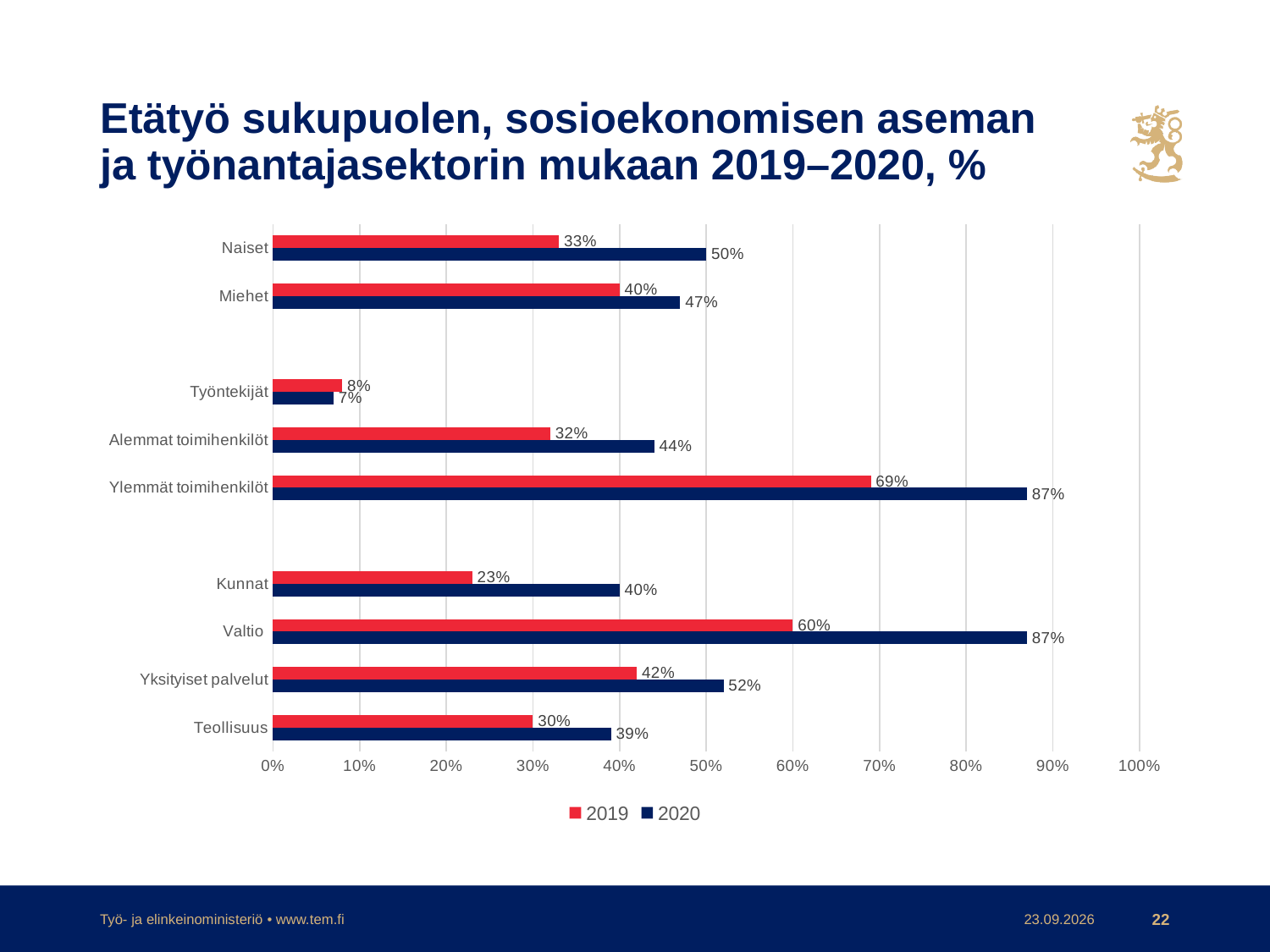
What is the 2019 value for Ylemmät toimihenkilöt? 69% What is the difference between the 2020 values for Alemmat toimihenkilöt and Teollisuus? 5% Which category has the highest 2019 value? Ylemmät toimihenkilöt Which is larger, the 2019 value for Miehet or the 2019 value for Naiset? Miehet How many series does the legend list? 2 Which category has the lowest 2020 value? Työntekijät What is the 2019 value for Kunnat? 23% What is the 2020 value for Naiset? 50% What is the difference between the 2020 and 2019 values for Valtio? 27% How many categories are shown on the chart? 9 What kind of chart is shown on the slide? Bar chart Which colour represents the 2020 series in the legend? Dark blue